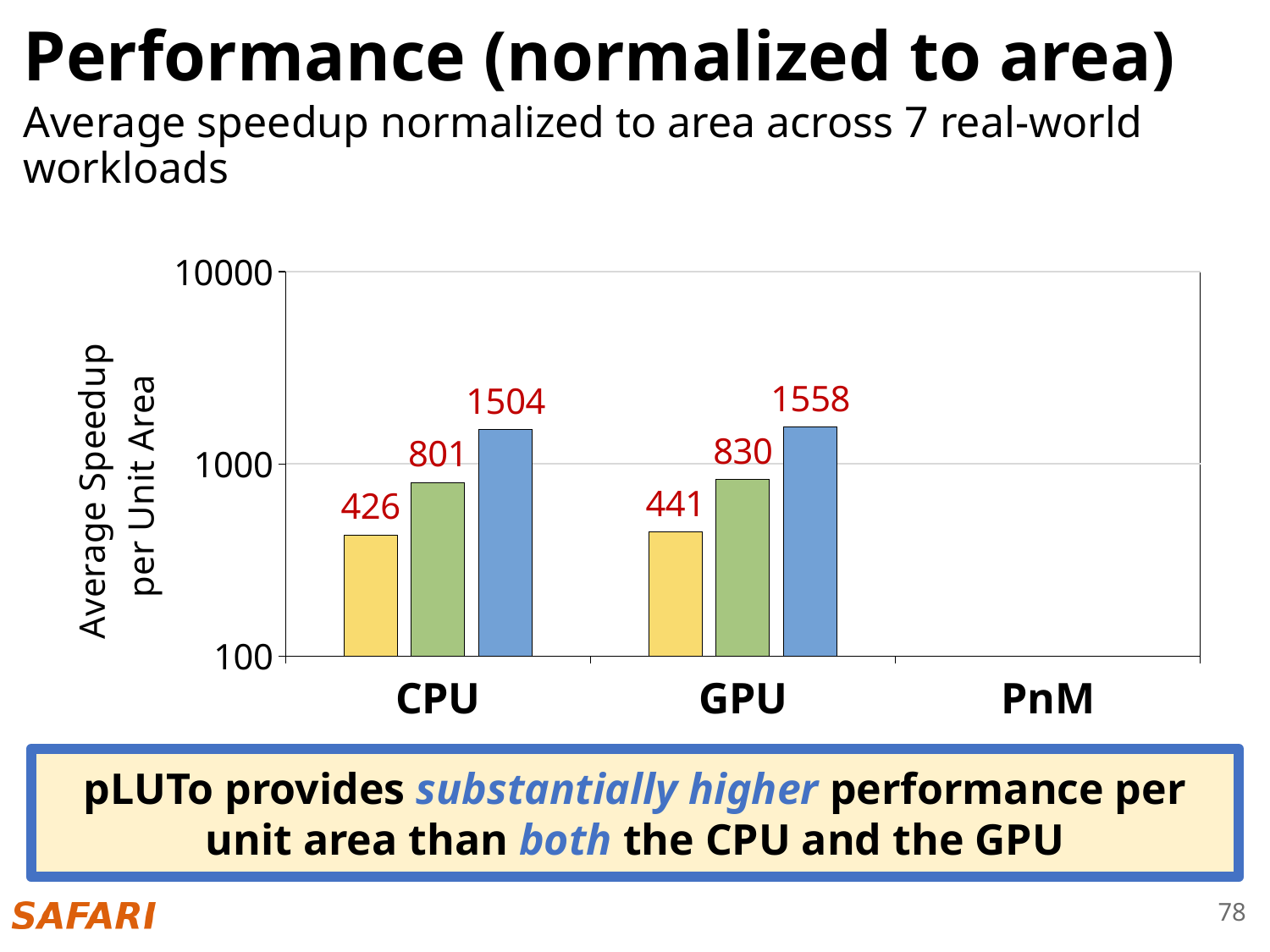
Is the value of the blue bar for CPU greater or less than 1000? greater What is the difference between the blue bar for GPU and the blue bar for CPU? 54 What is the difference between the green bar and the yellow bar for CPU? 375 Which is larger, the yellow bar for CPU or the yellow bar for GPU? The yellow bar for GPU (441) What is the value of the green bar for GPU? 830 What is the value of the green bar for CPU? 801 Which bar has the lowest value on the chart? The yellow bar for CPU (426) What is the value of the yellow bar for CPU? 426 Which bar has the highest value on the chart? The blue bar for GPU (1558) How many categories are labelled on the x axis? 3 What is the label of the y axis? Average Speedup per Unit Area What is the value of the blue bar for GPU? 1558